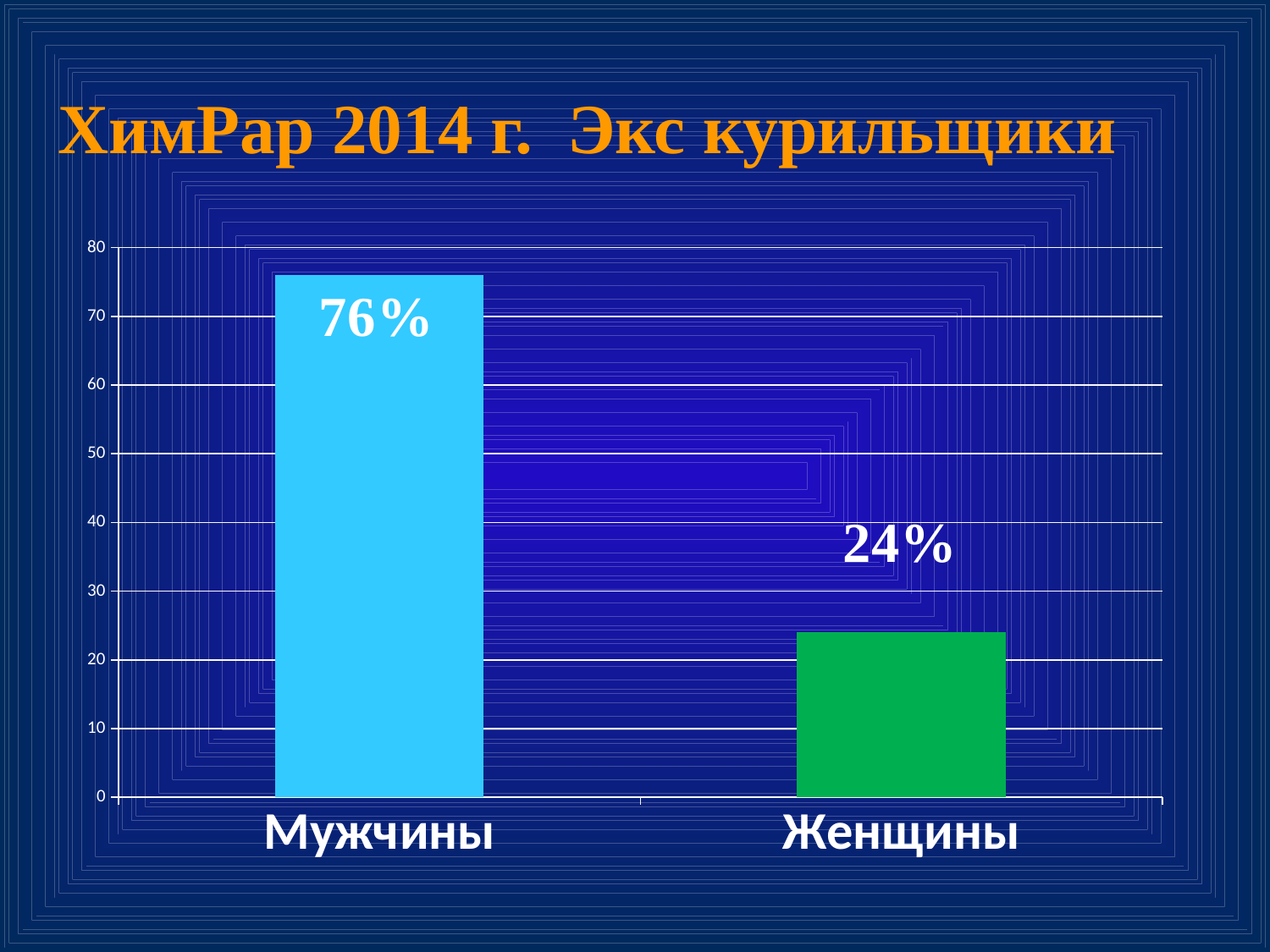
Which is larger, the value for Мужчины or the value for Женщины? Мужчины What is the difference between the values for Мужчины and Женщины? 52% Which category has the highest value? Мужчины How many categories are shown on the x axis? 2 What is the title of the slide? ХимРар 2014 г. Экс курильщики What is the value for Женщины? 24% Is the value for Мужчины greater or less than 70? greater What is the value for Мужчины? 76% Which category has the lowest value? Женщины What kind of chart is shown on the slide? bar chart What colour is the bar for Женщины? green Is the value for Женщины greater or less than 30? less